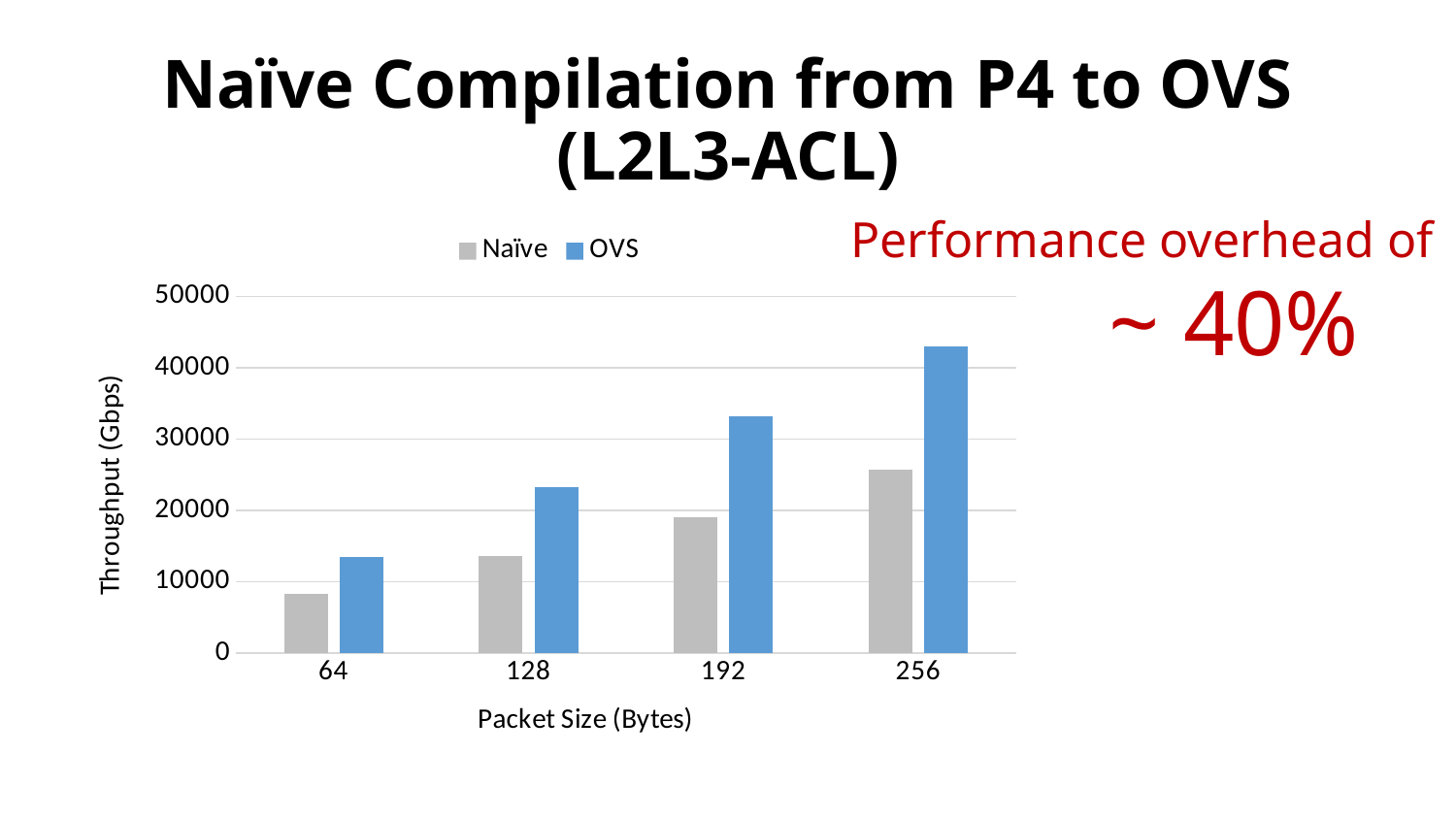
What is the label of the y axis? Throughput (Gbps) Is the OVS throughput at packet size 192 greater or less than 30000? greater How many series does the legend list? 2 Is the Naïve throughput at packet size 64 greater or less than 10000? less What kind of chart is shown on the slide? bar chart Which packet size has the lowest Naïve throughput? 64 Does the OVS throughput rise or fall as packet size increases? rise How many packet size categories are shown on the x axis? 4 Which series is shown in blue? OVS At packet size 128, which series has the larger throughput, Naïve or OVS? OVS Which packet size has the highest OVS throughput? 256 Is the OVS throughput at packet size 256 greater or less than 40000? greater